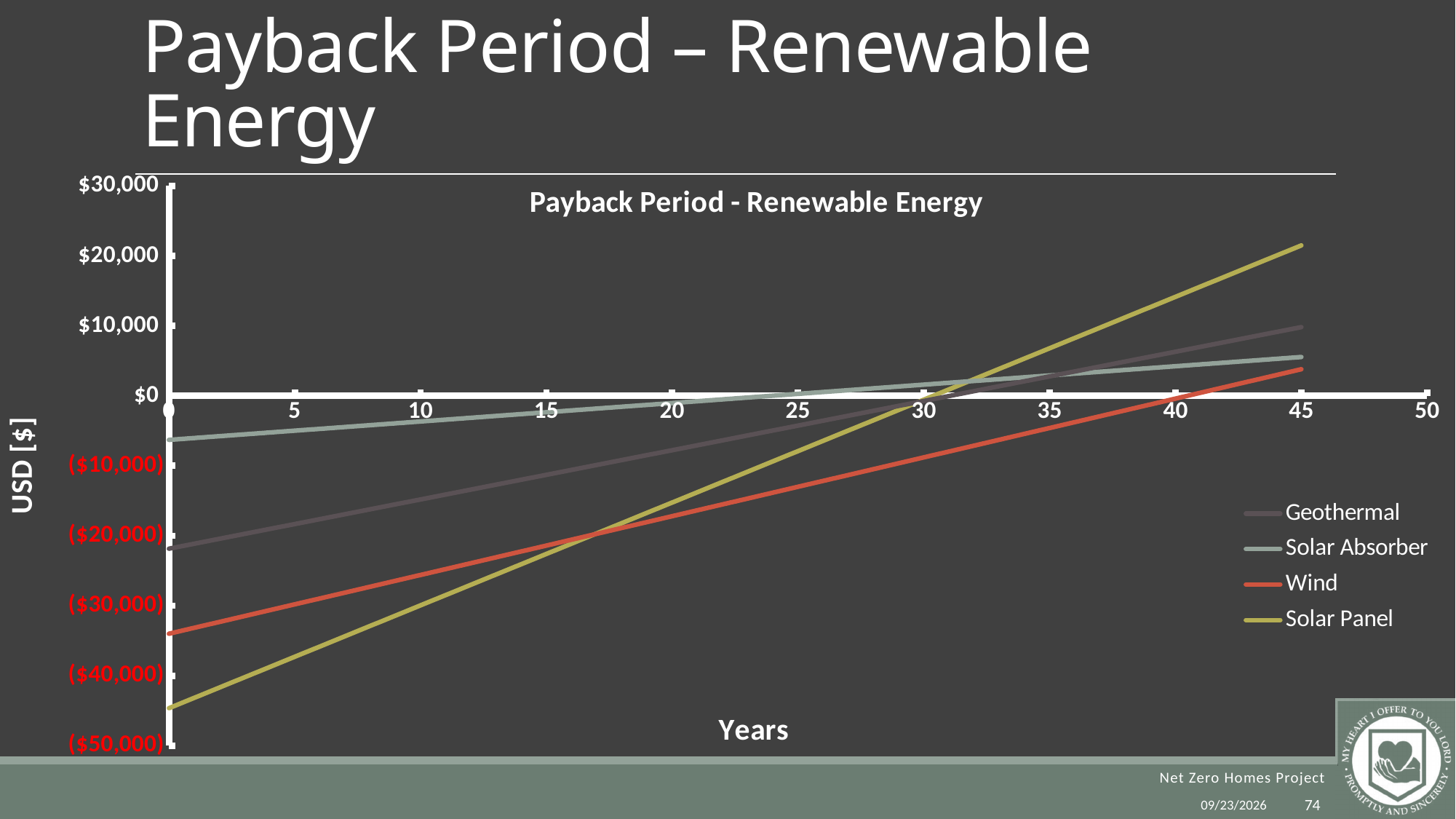
What is the label of the horizontal axis? Years Is the value for Solar Panel at year 45 greater or less than $20,000? greater Which series has the highest value at year 45? Solar Panel What kind of chart is shown on the slide? Line chart Is the value for Solar Panel at year 0 greater or less than ($40,000)? less What is the title of the chart? Payback Period - Renewable Energy Which series has the highest value at year 0? Solar Absorber At year 45, which is larger, the value for Geothermal or the value for Wind? Geothermal How many series does the chart legend list? 4 Is the value for Wind at year 0 greater or less than ($30,000)? less Do the values for Solar Panel rise or fall as the years increase? Rise Which series has the lowest value at year 0? Solar Panel